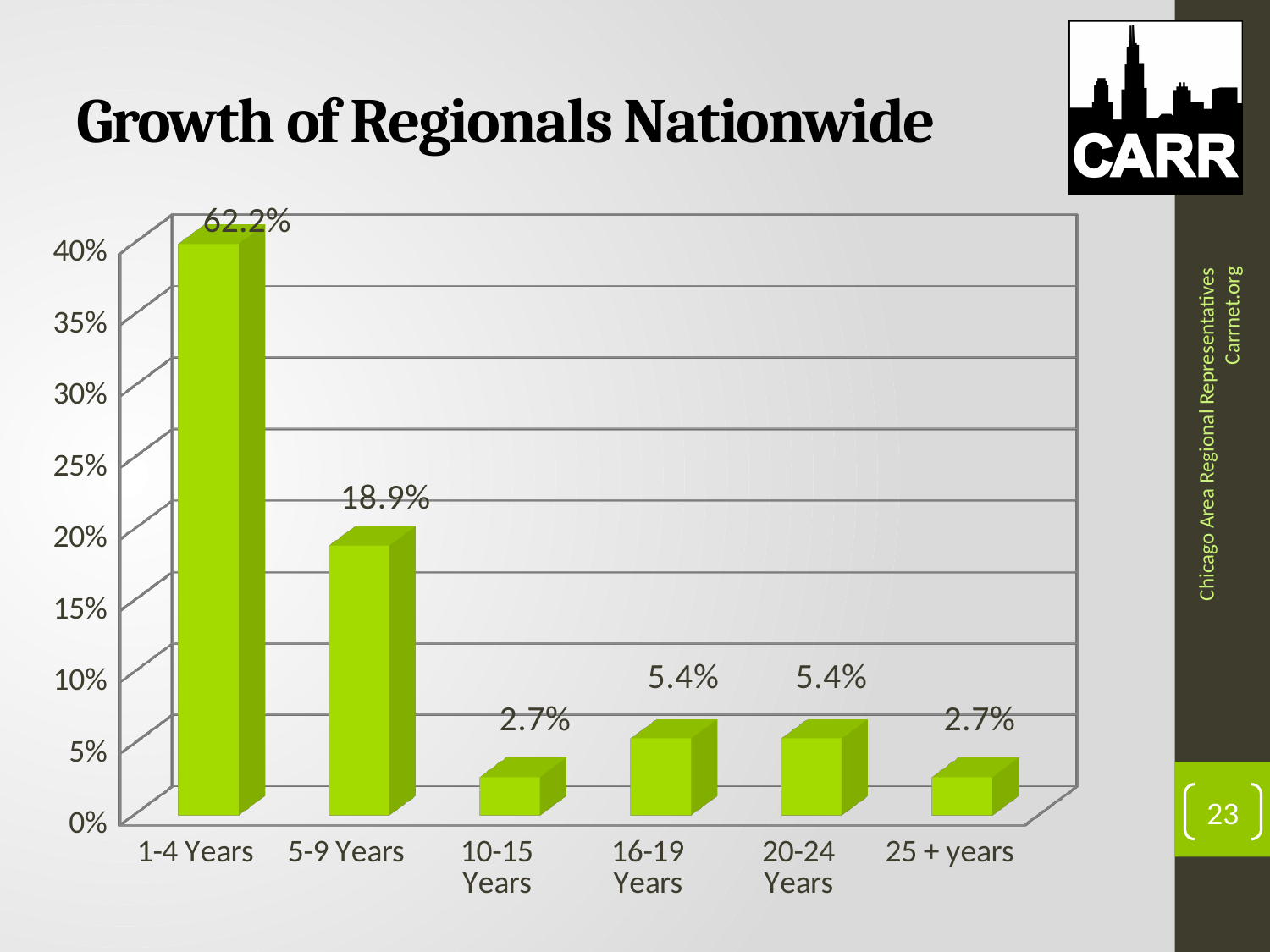
How many categories are shown on the x axis? 6 Which is larger, the value for 5-9 Years or the value for 20-24 Years? 5-9 Years What is the value for 25 + years? 2.7% What is the difference between the values for 1-4 Years and 5-9 Years? 43.3 percentage points Which category has the highest value? 1-4 Years What is the value for 5-9 Years? 18.9% What is the value for 1-4 Years? 62.2% What kind of chart is shown on the slide? bar chart What is the title of the slide containing the chart? Growth of Regionals Nationwide What is the difference between the values for 16-19 Years and 10-15 Years? 2.7 percentage points Is the value for 5-9 Years greater or less than 15%? greater What is the value for 16-19 Years? 5.4%